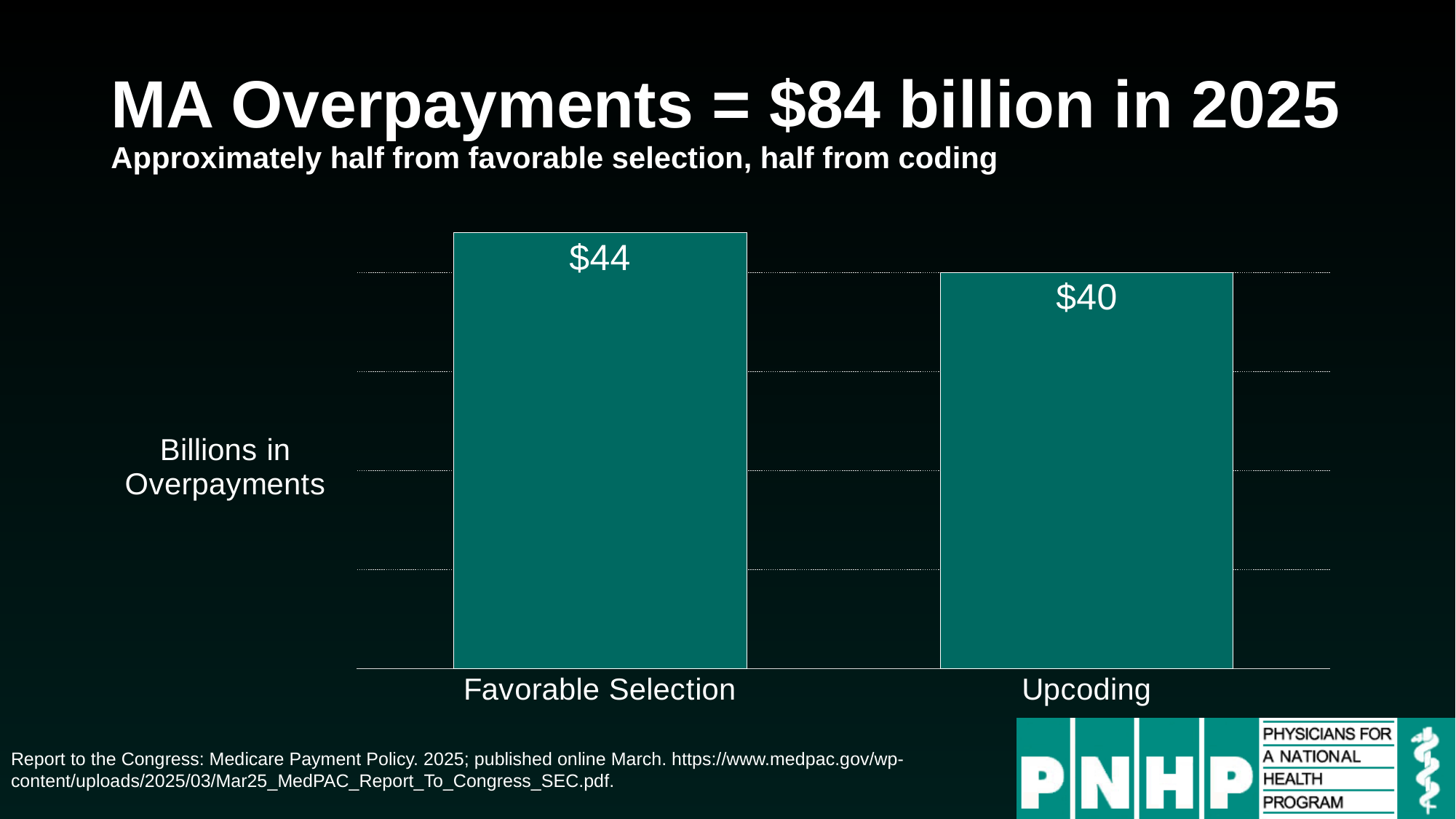
What kind of chart is shown on the slide? Bar chart What is the value for Favorable Selection? $44 Which is larger, the value for Favorable Selection or the value for Upcoding? Favorable Selection What is the value for Upcoding? $40 How many categories are shown in the chart? 2 What is the label on the vertical axis of the chart? Billions in Overpayments What is the title of the slide? MA Overpayments = $84 billion in 2025 What is the total of the two bars shown in the chart? $84 What is the difference between the values for Favorable Selection and Upcoding? $4 Which category has the highest value? Favorable Selection Which category has the lowest value? Upcoding